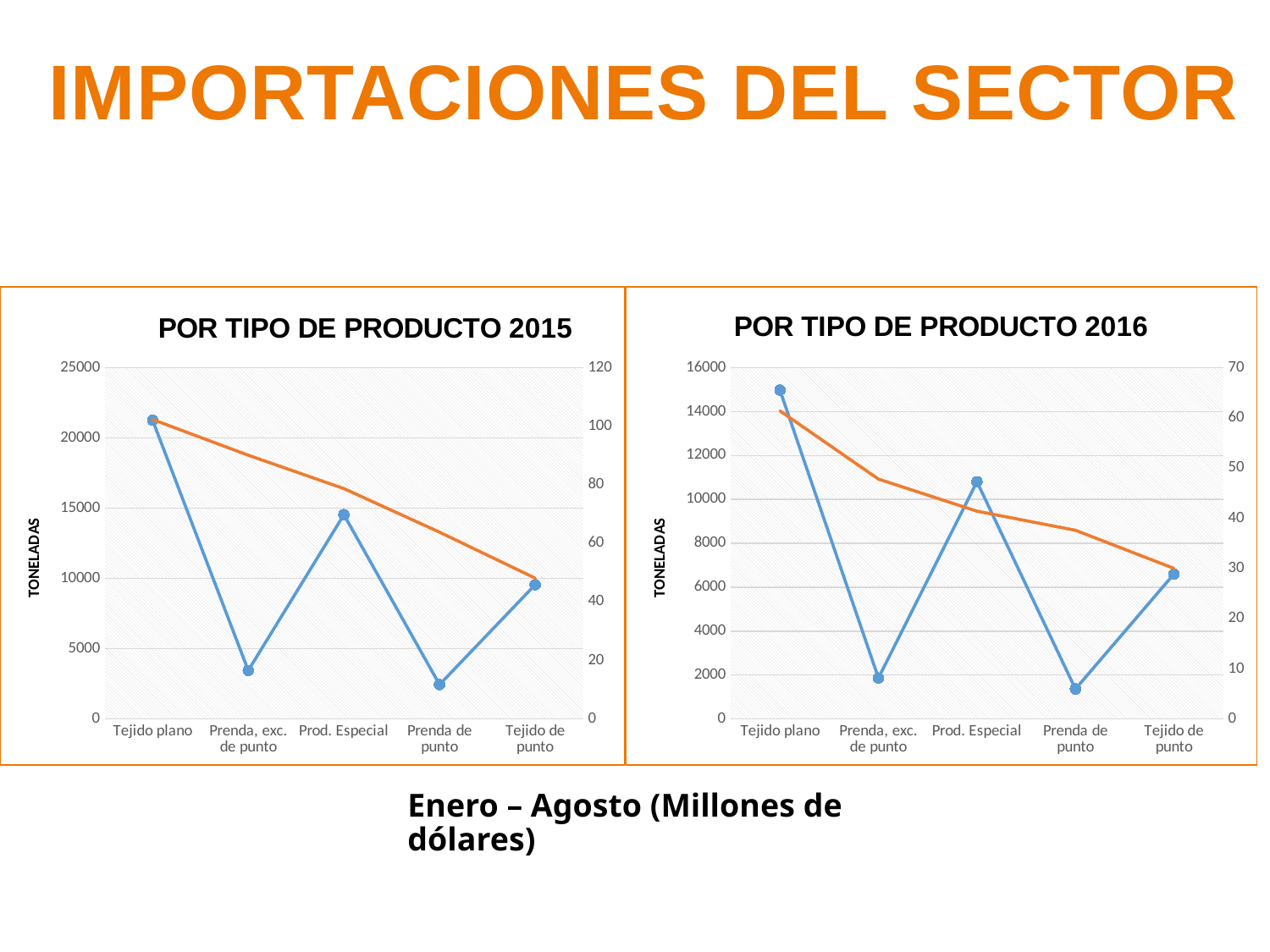
How many product categories are shown on the x axis of the 'POR TIPO DE PRODUCTO 2016' chart? 5 In the 'POR TIPO DE PRODUCTO 2016' chart, is the blue-line value for Tejido de punto greater or less than 8000? less In the 'POR TIPO DE PRODUCTO 2015' chart, which category has the lowest value on the blue line with markers? Prenda de punto What is the label on the left vertical axis of the 'POR TIPO DE PRODUCTO 2015' chart? TONELADAS In the 'POR TIPO DE PRODUCTO 2015' chart, which category has the highest value on the blue line with markers? Tejido plano In the 'POR TIPO DE PRODUCTO 2016' chart, which category has the highest value on the blue line with markers? Tejido plano What is the title of the chart on the right side of the slide? POR TIPO DE PRODUCTO 2016 In the 'POR TIPO DE PRODUCTO 2015' chart, which has the larger blue-line value: Prod. Especial or Tejido de punto? Prod. Especial In the 'POR TIPO DE PRODUCTO 2016' chart, does the orange line rise or fall from Tejido plano to Tejido de punto? Falls In the 'POR TIPO DE PRODUCTO 2015' chart, is the blue-line value for Tejido plano greater or less than 20000? greater What type of chart is 'POR TIPO DE PRODUCTO 2015'? Line chart In the 'POR TIPO DE PRODUCTO 2016' chart, is the blue-line value for Prod. Especial greater or less than 10000? greater